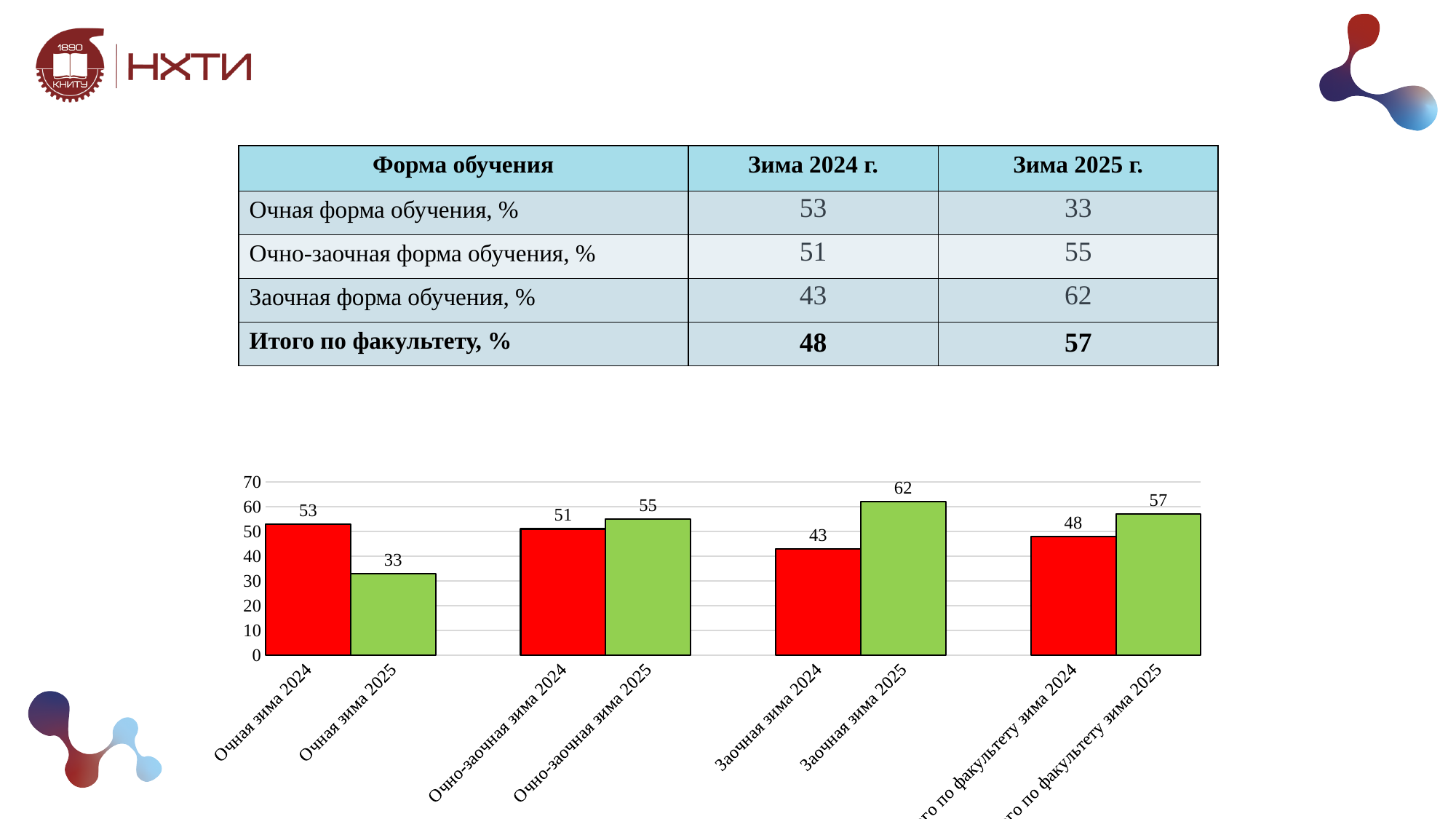
Which is larger: the value for "Очно-заочная зима 2025" or the value for "Очно-заочная зима 2024"? Очно-заочная зима 2025 What is the value of the bar labelled "Очно-заочная зима 2024"? 51 What is the value of the bar labelled "Заочная зима 2025"? 62 What is the value of the bar labelled "Очная зима 2025"? 33 How many bars are plotted in the chart? 8 What is the difference between the values for "Очная зима 2024" and "Очная зима 2025"? 20 What kind of chart is shown on the slide? bar chart What colour are the bars for the 2025 values in the chart? green What is the value of the bar labelled "Очная зима 2024"? 53 Which bar has the highest value in the chart? Заочная зима 2025 What is the difference between the values for "Заочная зима 2025" and "Заочная зима 2024"? 19 Which bar has the lowest value in the chart? Очная зима 2025